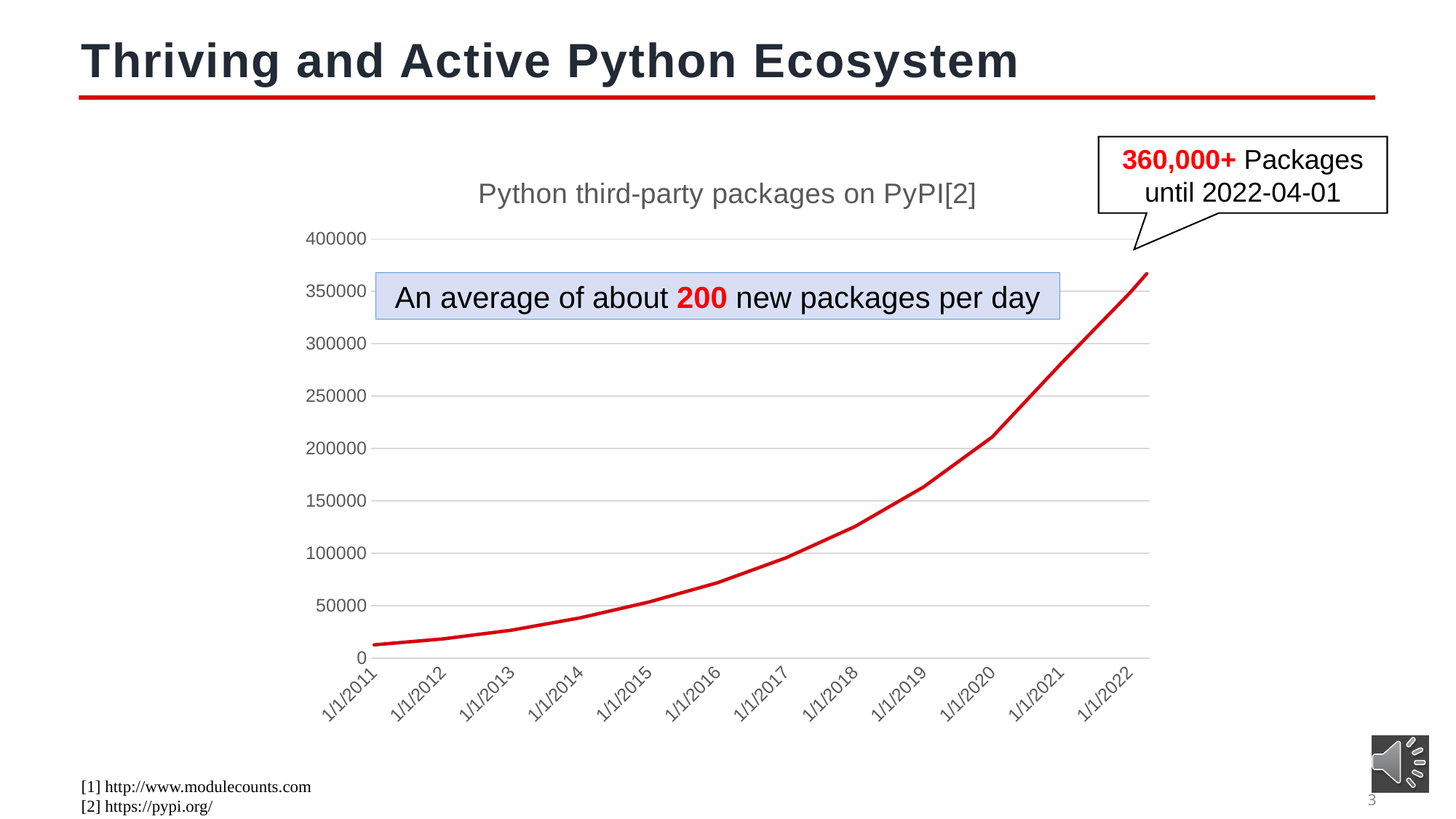
Is the value for 1/1/2018 greater or less than 100000? greater At which labelled date is the number of packages lowest? 1/1/2011 Is the value for 1/1/2019 greater or less than 150000? greater Which is larger, the value for 1/1/2016 or the value for 1/1/2020? 1/1/2020 What kind of chart is shown on the slide? line chart Is the value for 1/1/2021 greater or less than 250000? greater At which labelled date is the number of packages highest? 1/1/2022 What colour is the line in the chart? red Do the values rise or fall along the x axis from 1/1/2011 to 1/1/2022? rise What is the title of the chart? Python third-party packages on PyPI[2] How many dates are labelled on the x axis of the chart? 12